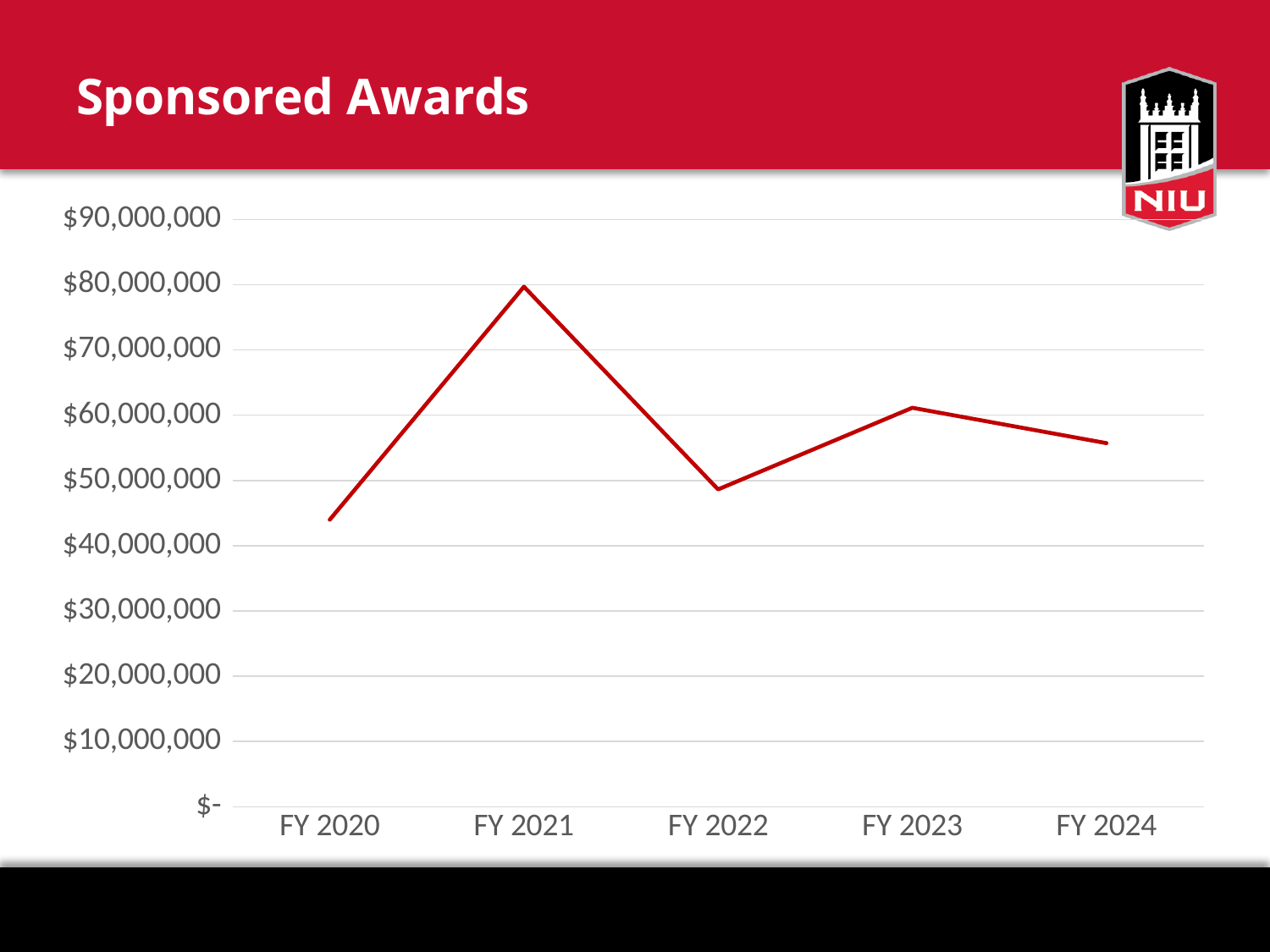
How many fiscal years are plotted on the x axis? 5 Is the value for FY 2024 greater or less than $60,000,000? less Which fiscal year has the lowest sponsored awards value? FY 2020 Is the value for FY 2022 greater or less than $60,000,000? less Which is larger, the value for FY 2023 or the value for FY 2024? FY 2023 What is the title of the chart? Sponsored Awards Which fiscal year has the highest sponsored awards value? FY 2021 Is the value for FY 2021 greater or less than $70,000,000? greater Which is larger, the value for FY 2020 or the value for FY 2022? FY 2022 What kind of chart is shown on the slide? line chart Does the line rise or fall from FY 2021 to FY 2022? fall